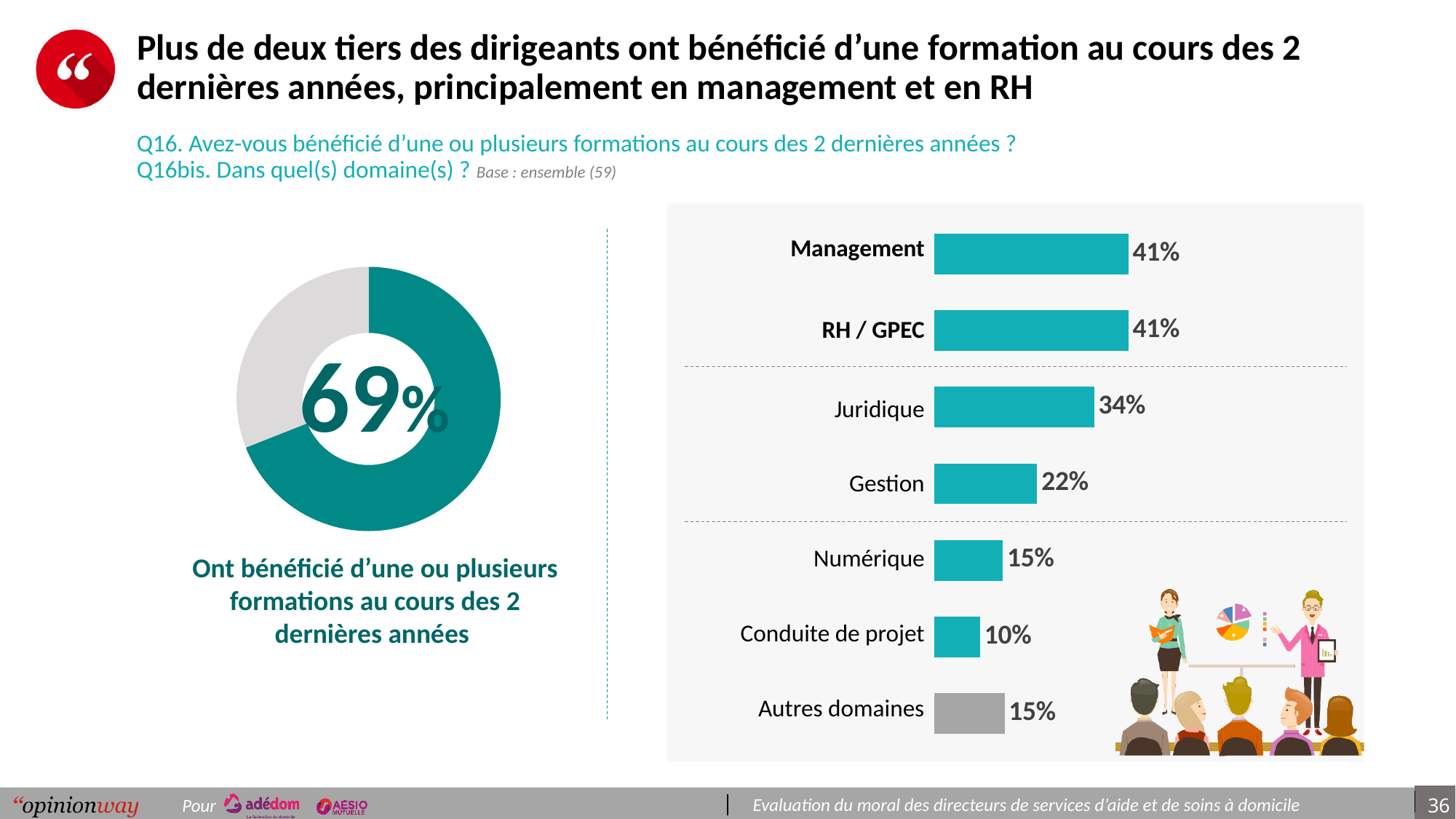
In the bar chart on the right, what is the value for Gestion? 22% In the bar chart on the right, which category is drawn in grey rather than teal? Autres domaines In the bar chart on the right, which category has the lowest value? Conduite de projet In the bar chart on the right, what is the difference between Juridique and Gestion? 12 percentage points How many categories are shown in the bar chart on the right? 7 In the bar chart on the right, which is larger: Numérique or Conduite de projet? Numérique In the bar chart on the right, what is the value for Conduite de projet? 10% What kind of chart is shown on the left of the slide? Donut (pie) chart In the bar chart on the right, what is the value for Juridique? 34% In the donut chart on the left, what percentage of respondents have benefited from one or more training courses in the last 2 years? 69% In the bar chart on the right, which two categories share the highest value? Management and RH / GPEC What kind of chart is shown on the right of the slide? Bar chart